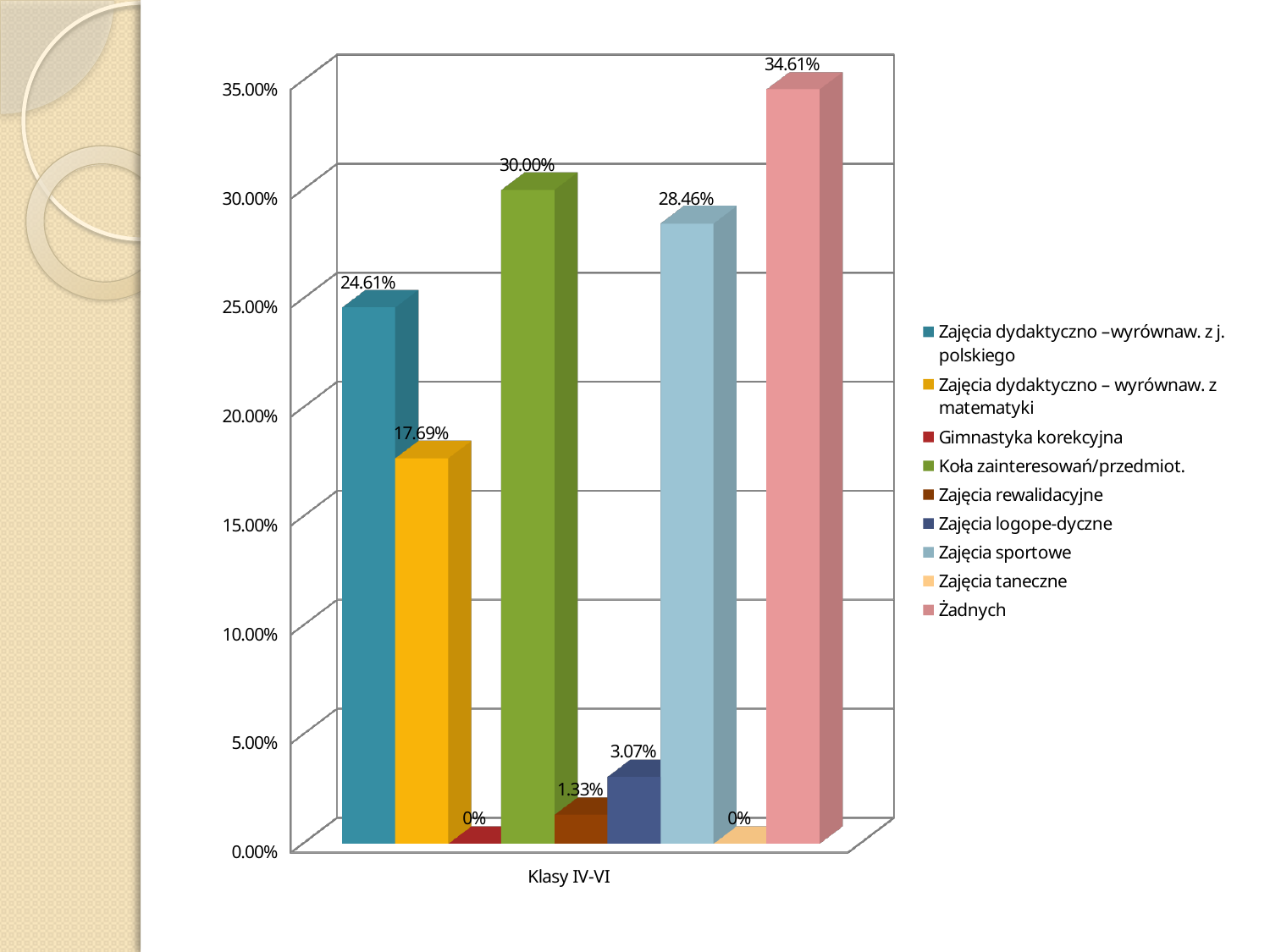
What kind of chart is shown on the slide? Bar chart What is the value for Zajęcia logope-dyczne? 3.07% How many series have a value of 0%? 2 Which series has the lowest non-zero value? Zajęcia rewalidacyjne What is the difference between the values for Żadnych and Koła zainteresowań/przedmiot.? 4.61% What is the category label shown on the x axis? Klasy IV-VI What is the value for Żadnych? 34.61% What is the value for Zajęcia sportowe? 28.46% Which series has the highest value? Żadnych Which is larger, the value for Zajęcia sportowe or the value for Zajęcia dydaktyczno –wyrównaw. z j. polskiego? Zajęcia sportowe What is the value for Zajęcia dydaktyczno – wyrównaw. z matematyki? 17.69% How many series does the legend list? 9